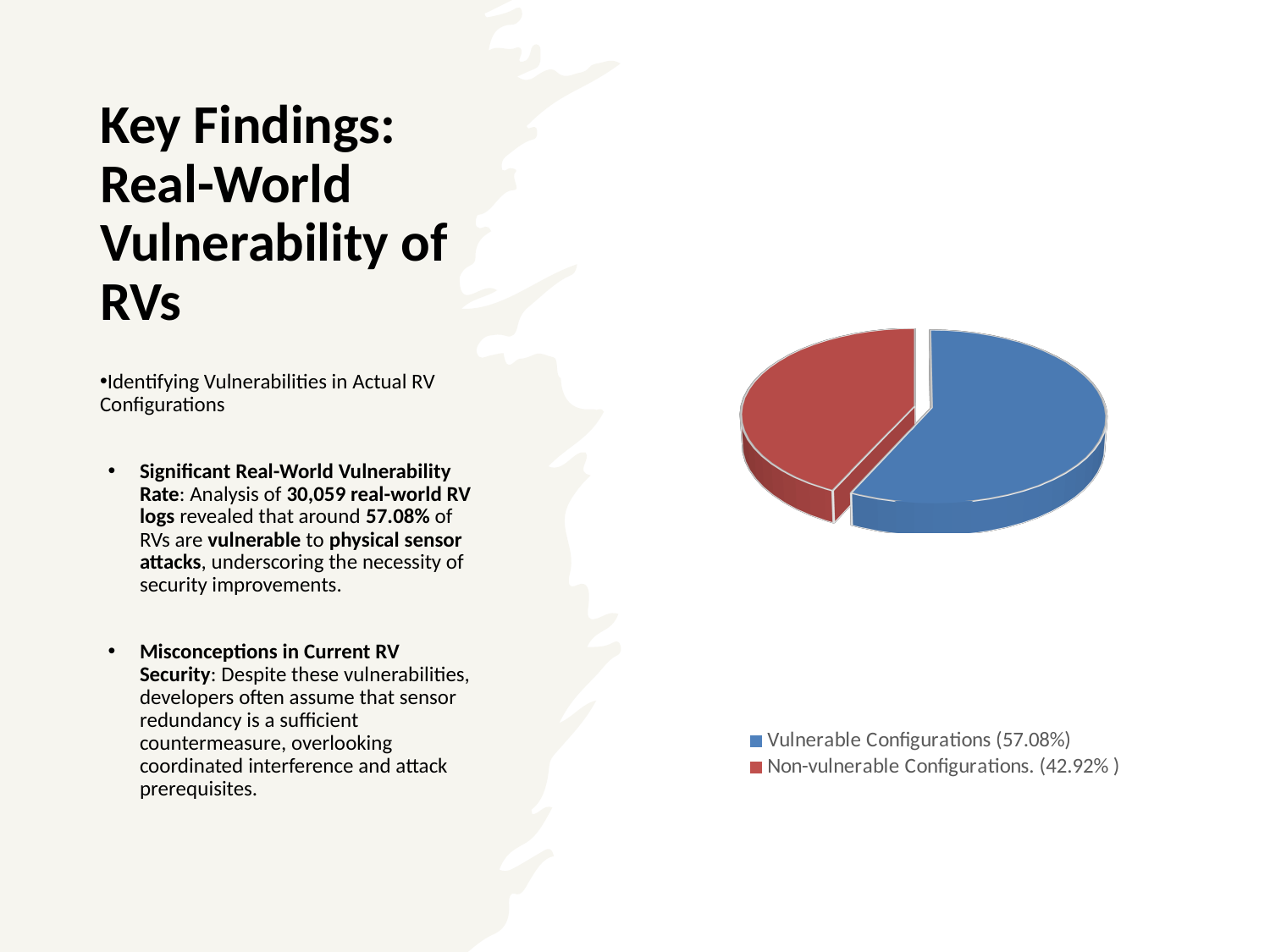
What share of the pie is Vulnerable Configurations? 57.08% What colour is the Non-vulnerable Configurations slice in the pie chart? red Which is larger in the pie chart: Vulnerable Configurations or Non-vulnerable Configurations? Vulnerable Configurations What is the difference in percentage points between the Vulnerable Configurations and Non-vulnerable Configurations slices? 14.16 How many entries does the legend of the pie chart list? 2 Which slice of the pie chart is the largest? Vulnerable Configurations How many slices does the pie chart have? 2 What share of the pie is Non-vulnerable Configurations? 42.92% Which slice of the pie chart is the smallest? Non-vulnerable Configurations What colour is the Vulnerable Configurations slice in the pie chart? blue What kind of chart is shown on the slide? pie chart